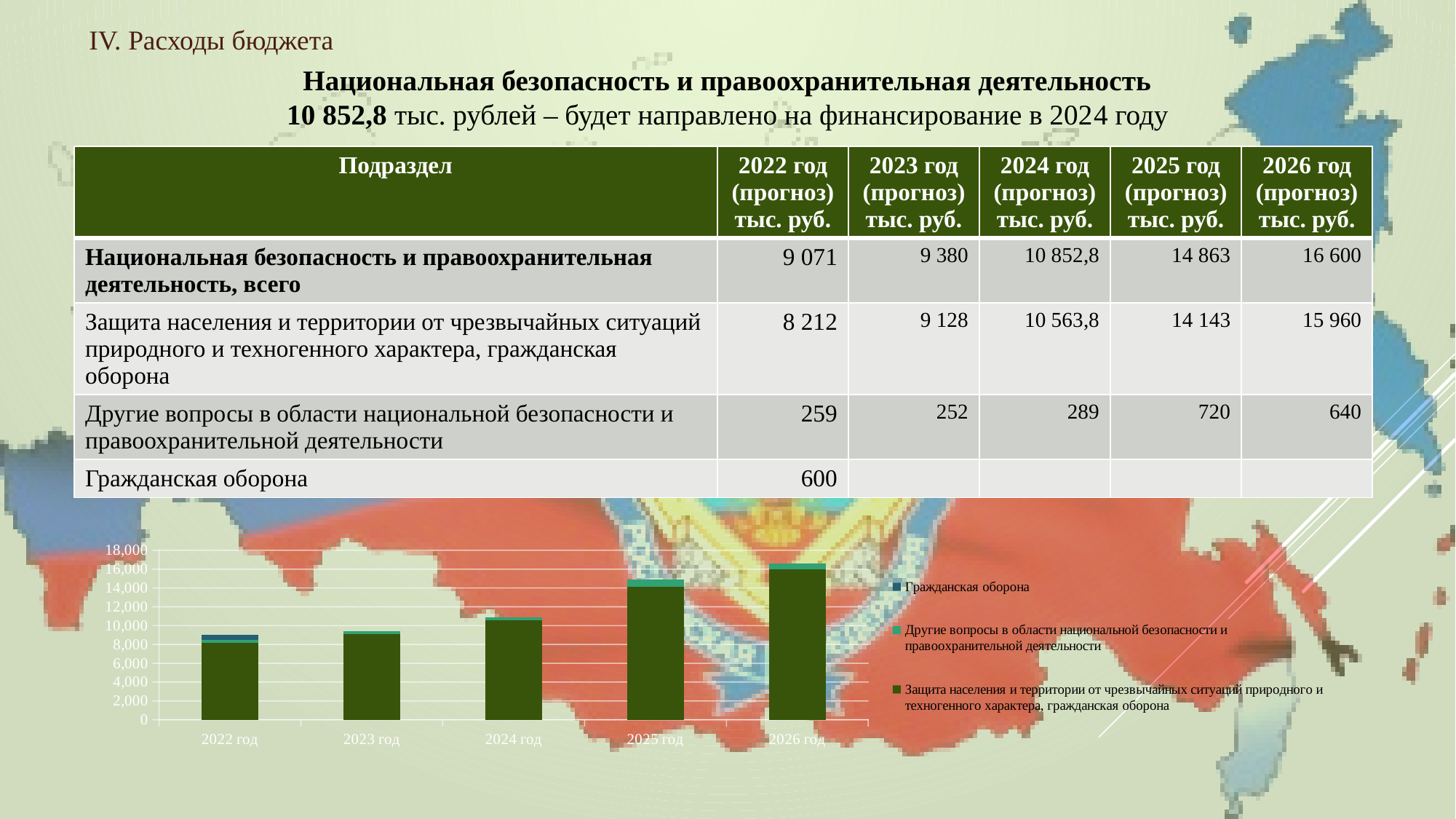
How many series does the chart legend list? 3 Do the stacked bar totals rise or fall from 2022 год to 2026 год? rise Which year has the tallest stacked bar in the chart? 2026 год Is the total stacked bar for 2025 год greater or less than 12,000? greater Which series is listed first in the chart legend? Гражданская оборона How many year categories are shown on the x axis of the chart? 5 Is the total stacked bar for 2023 год greater or less than 10,000? less Is the total stacked bar for 2022 год greater or less than 8,000? greater What kind of chart is shown at the bottom of the slide? bar chart Which series forms the large dark green segment of each bar in the chart? Защита населения и территории от чрезвычайных ситуаций природного и техногенного характера, гражданская оборона Which stacked bar is taller, 2025 год or 2024 год? 2025 год